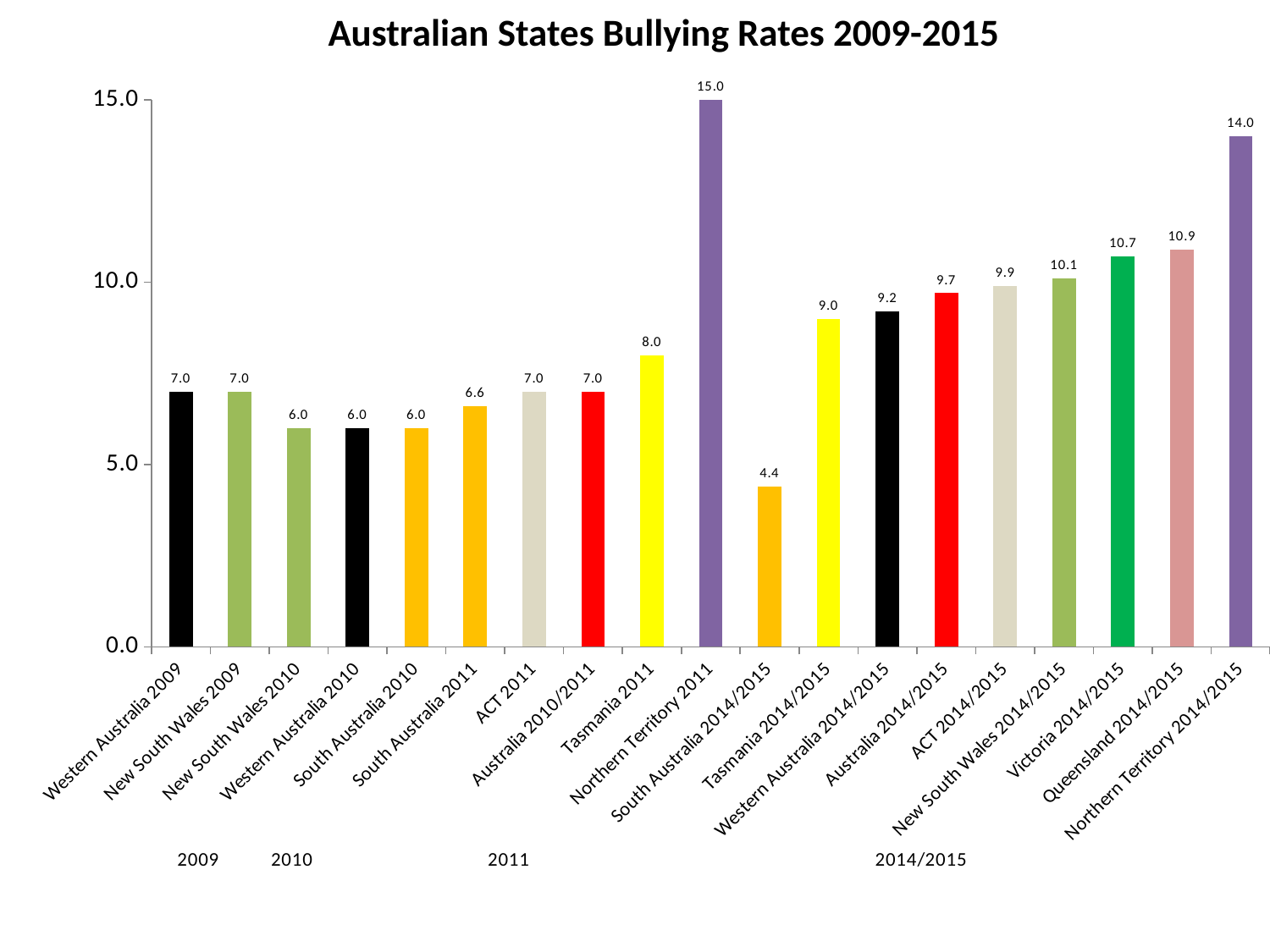
What is the value shown for South Australia 2014/2015? 4.4 Which category has the highest value on the chart? Northern Territory 2011 What is the value shown for Queensland 2014/2015? 10.9 What is the bullying rate shown for Northern Territory 2011? 15.0 Which is larger, the value for Victoria 2014/2015 or the value for ACT 2014/2015? Victoria 2014/2015 What is the difference between the values for Tasmania 2014/2015 and Tasmania 2011? 1.0 What type of chart is shown on the slide? Bar chart Which category has the lowest value on the chart? South Australia 2014/2015 How many bars are plotted on the chart? 19 What is the difference between the values for Northern Territory 2011 and Northern Territory 2014/2015? 1.0 What is the value shown for South Australia 2011? 6.6 Is the value for Western Australia 2014/2015 greater or less than 10.0? less